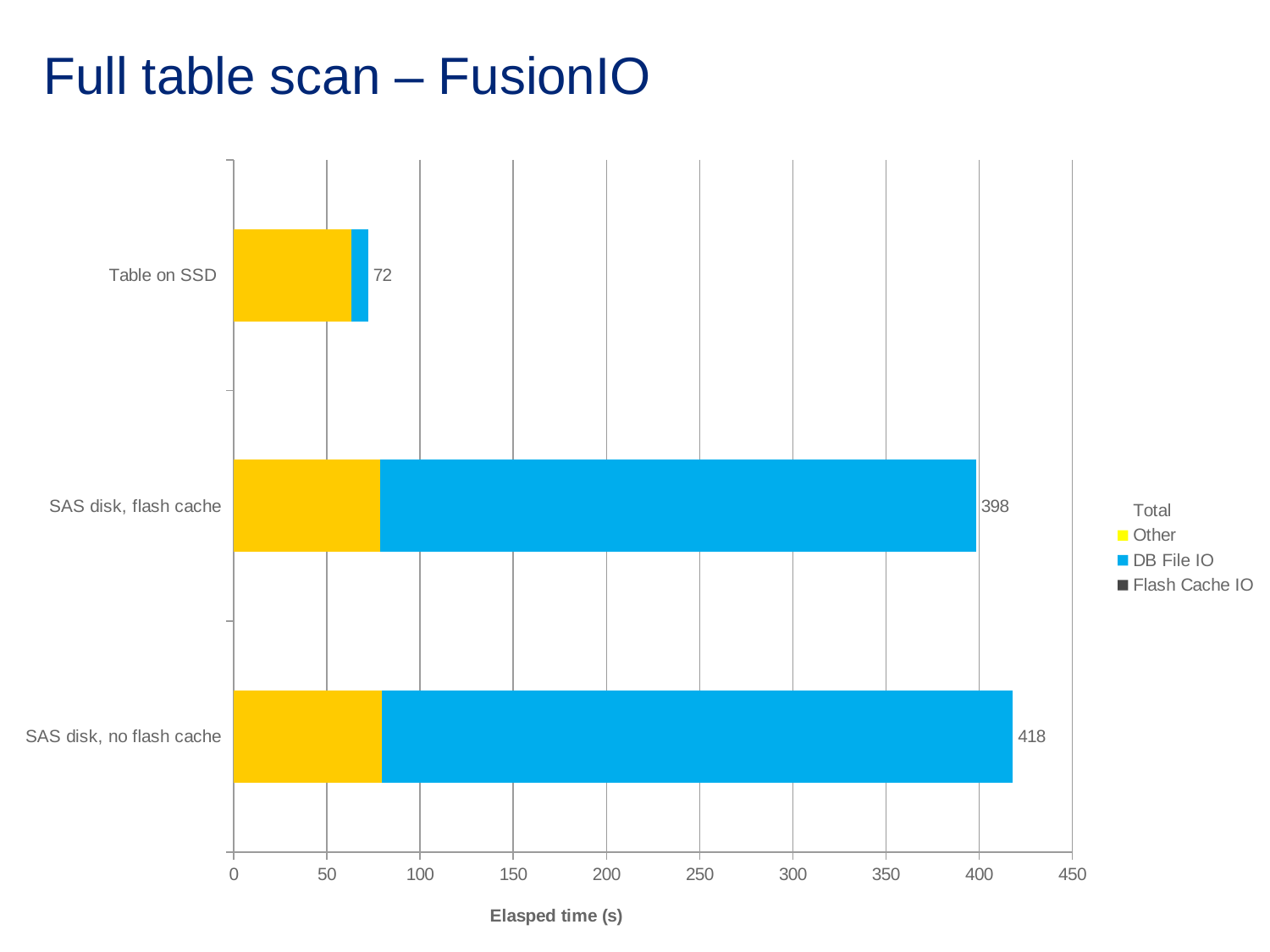
What is the difference in total elapsed time between "SAS disk, no flash cache" and "SAS disk, flash cache"? 20 What is the total elapsed time for "Table on SSD"? 72 Which category has the highest total elapsed time? SAS disk, no flash cache What is the total elapsed time for "SAS disk, flash cache"? 398 What is the total elapsed time for "SAS disk, no flash cache"? 418 Which category has the lowest total elapsed time? Table on SSD Is the "DB File IO" value for "SAS disk, flash cache" greater or less than 300? greater Which has a larger total elapsed time, "Table on SSD" or "SAS disk, flash cache"? SAS disk, flash cache Is the "Other" value for "Table on SSD" greater or less than 100? less How many categories are shown on the chart? 3 What kind of chart is shown on the slide? Stacked bar chart What is the difference in total elapsed time between "SAS disk, flash cache" and "Table on SSD"? 326